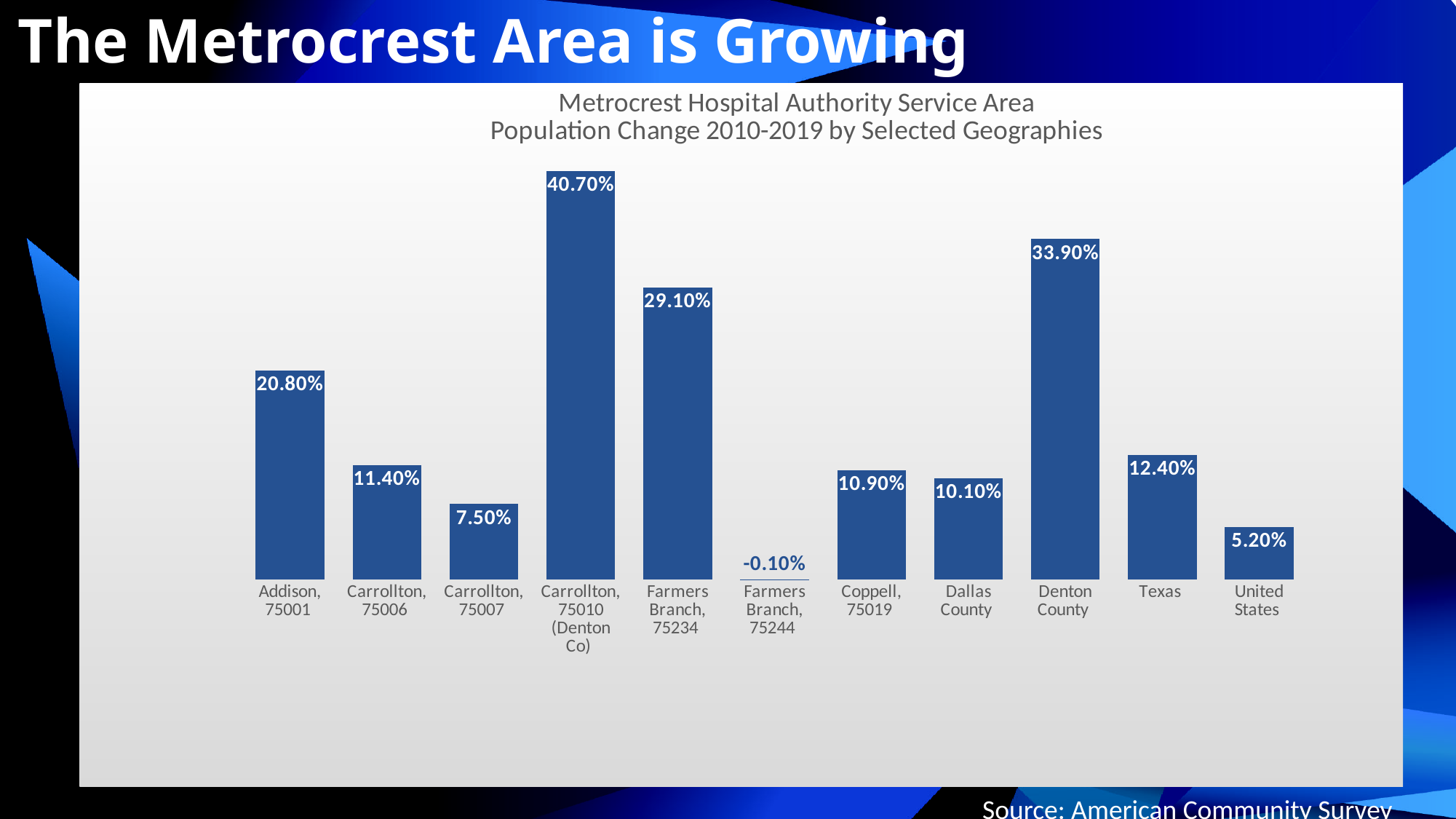
What is the population change value for Denton County? 33.90% What is the difference between the population change for Texas and the United States? 7.20% What is the difference between the population change for Carrollton, 75010 (Denton Co) and Farmers Branch, 75234? 11.60% What is the population change value for Farmers Branch, 75244? -0.10% What kind of chart is shown on the slide? Bar chart Which geography has the highest population change? Carrollton, 75010 (Denton Co) Which has a larger population change, Coppell, 75019 or Dallas County? Coppell, 75019 What is the population change value for the United States? 5.20% How many geographies are shown in the chart? 11 What is the title of the chart? Metrocrest Hospital Authority Service Area Population Change 2010-2019 by Selected Geographies Which geography has the lowest population change? Farmers Branch, 75244 What is the population change value for Addison, 75001? 20.80%